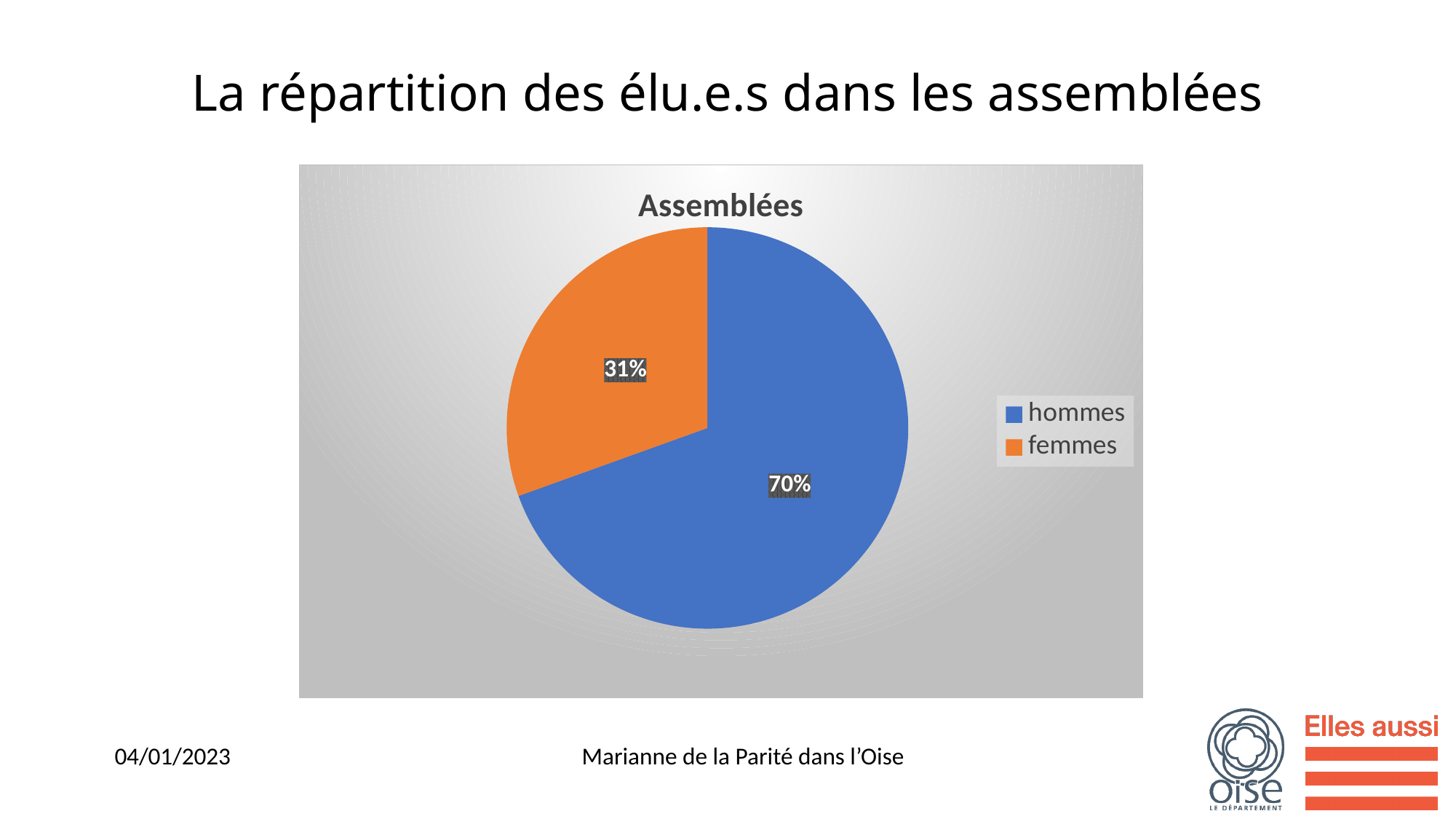
What colour is the femmes slice? orange How many slices does the pie chart have? 2 How many entries does the legend list? 2 What is the chart's title? Assemblées Which category has the smallest slice of the pie? femmes Which category has the largest slice of the pie? hommes What is the difference in percentage points between the hommes and femmes slices? 39 What share of the pie is labelled for hommes? 70% Which slice is larger, hommes or femmes? hommes What kind of chart is shown on the slide? pie chart What share of the pie is labelled for femmes? 31%